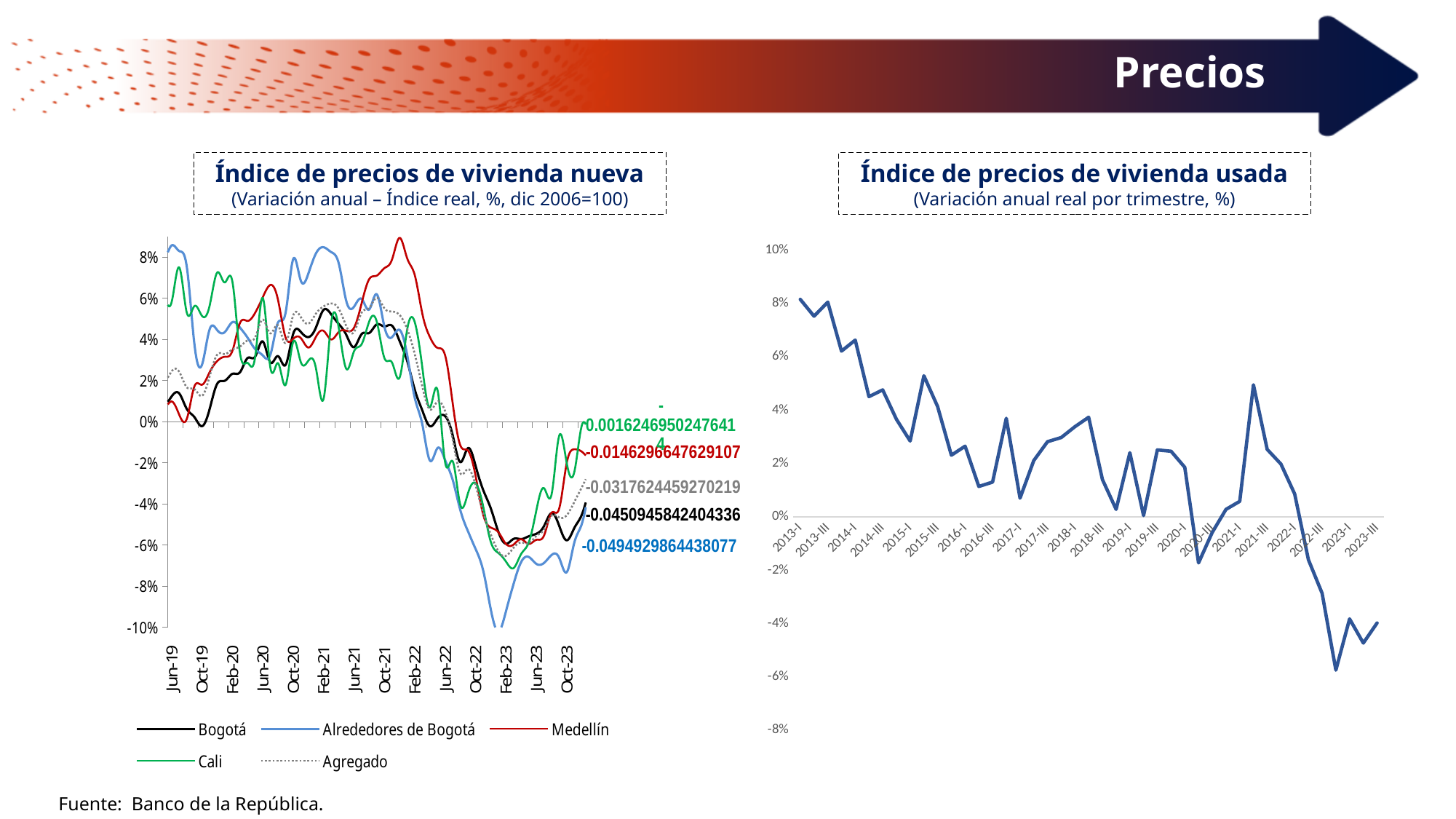
In the 'Índice de precios de vivienda nueva' chart, what is the final data label shown for Bogotá? -0.0450945842404336 In the 'Índice de precios de vivienda usada' chart, is the value for 2013-I greater or less than 6%? greater In the 'Índice de precios de vivienda nueva' chart, which series has the highest final labelled value? Cali In the 'Índice de precios de vivienda nueva' chart, what is the final data label shown for Medellín? -0.0146296647629107 In the 'Índice de precios de vivienda nueva' chart, which has the larger final labelled value, Medellín or Bogotá? Medellín In the 'Índice de precios de vivienda nueva' chart, what is the final data label shown for Agregado? -0.0317624459270219 What kind of chart is the 'Índice de precios de vivienda usada' chart on the right? line chart How many series does the legend of the 'Índice de precios de vivienda nueva' chart list? 5 In the 'Índice de precios de vivienda nueva' chart, what is the final data label shown for Alrededores de Bogotá? -0.0494929864438077 What kind of chart is the 'Índice de precios de vivienda nueva' chart on the left? line chart In the 'Índice de precios de vivienda nueva' chart, which series has the lowest final labelled value? Alrededores de Bogotá In the 'Índice de precios de vivienda usada' chart, do the values overall rise or fall from 2013-I to 2023-III? fall